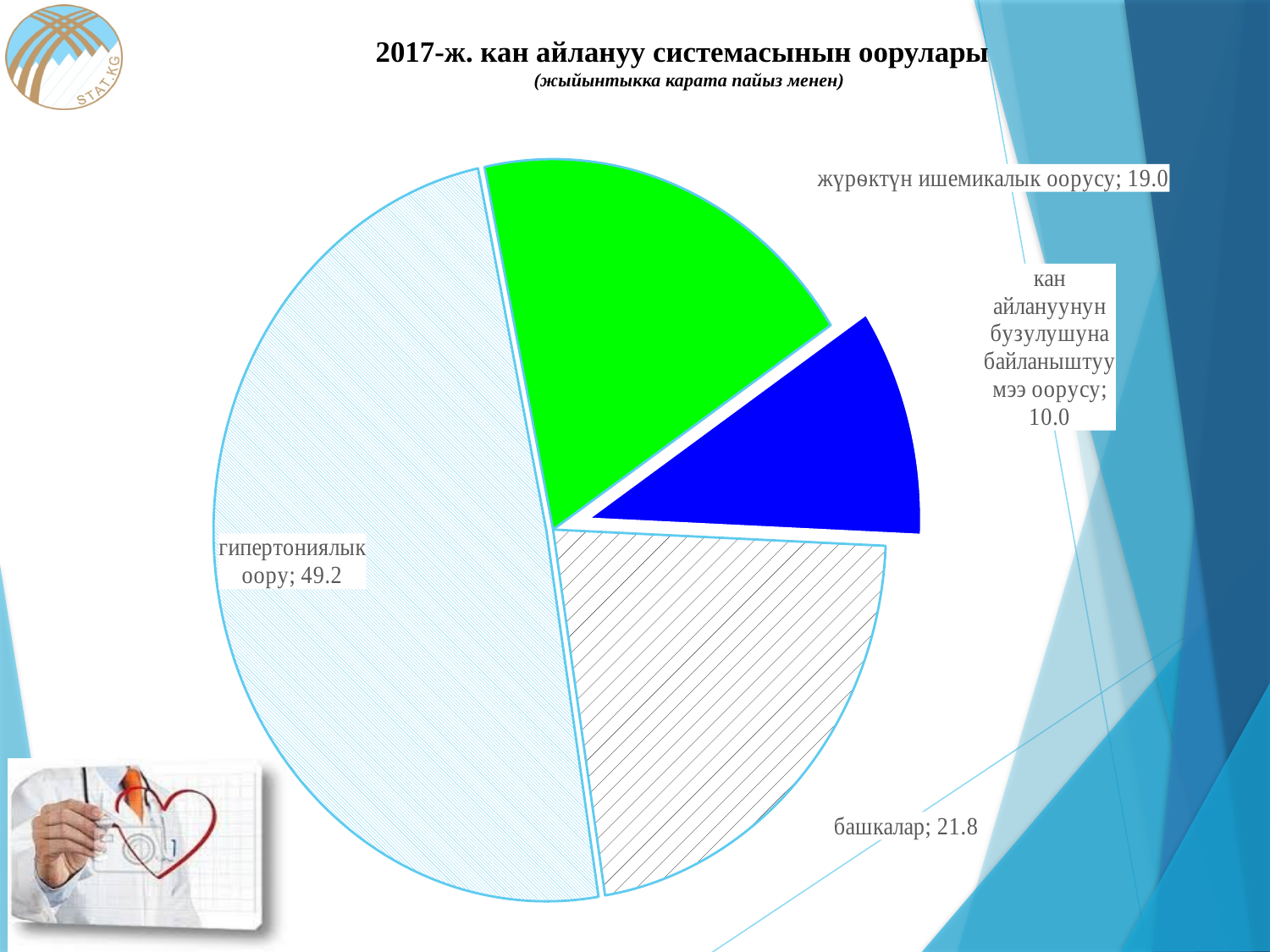
Which is larger, the value for башкалар or the value for жүрөктүн ишемикалык оорусу? башкалар What is the value for гипертониялык оору? 49.2 What is the value for башкалар? 21.8 What is the difference between the values for жүрөктүн ишемикалык оорусу and кан айлануунун бузулушуна байланыштуу мээ оорусу? 9.0 Which category has the largest share of the pie? гипертониялык оору What is the value for жүрөктүн ишемикалык оорусу? 19.0 What kind of chart is shown on the slide? pie chart How many slices does the pie chart have? 4 What is the value for кан айлануунун бузулушуна байланыштуу мээ оорусу? 10.0 What is the title of the chart? 2017-ж. кан айлануу системасынын оорулары What is the difference between the values for гипертониялык оору and башкалар? 27.4 Which category has the smallest share of the pie? кан айлануунун бузулушуна байланыштуу мээ оорусу